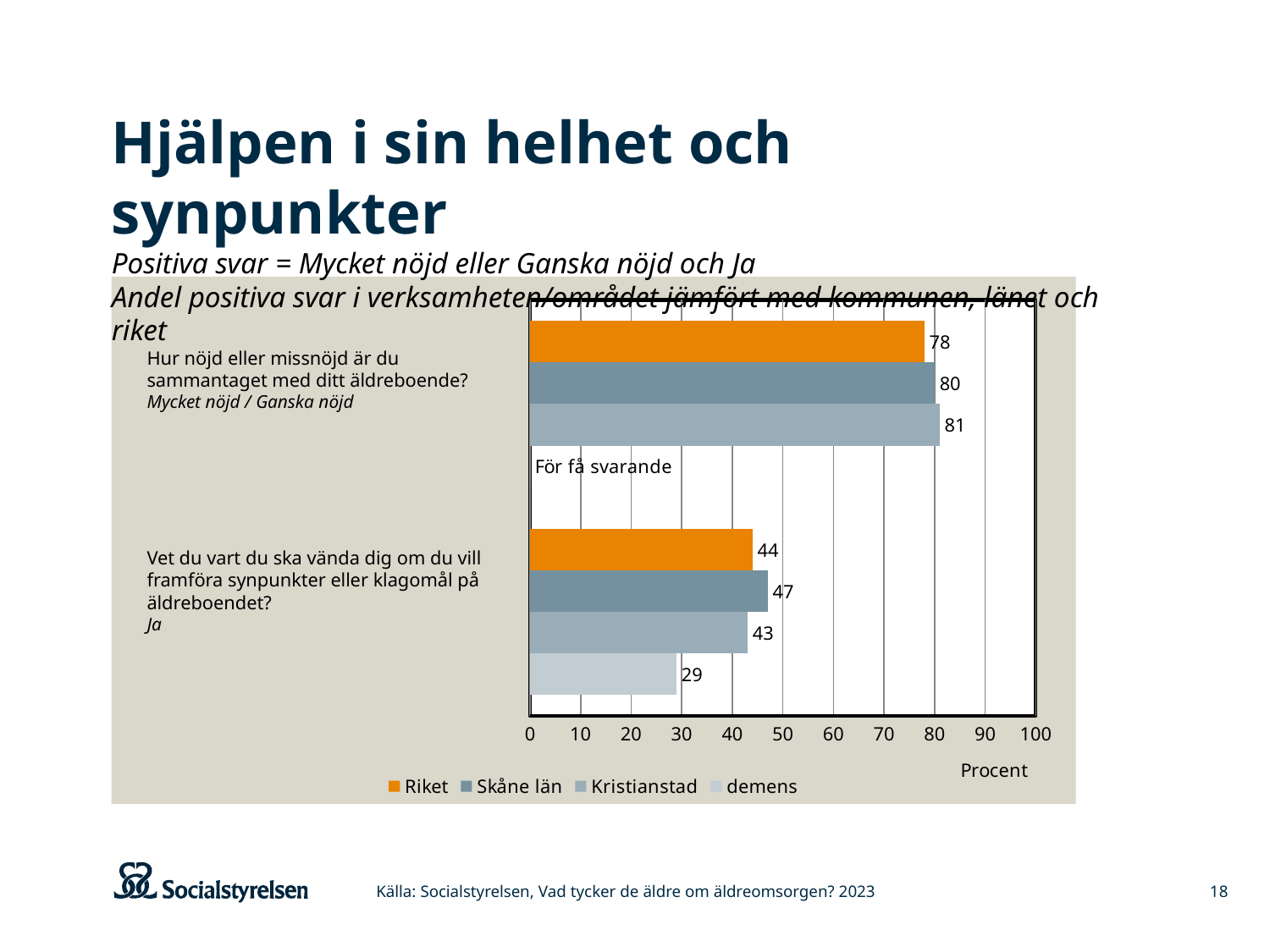
What is the label of the x axis? Procent Which is larger on the question "Vet du vart du ska vända dig om du vill framföra synpunkter eller klagomål på äldreboendet?": Riket or demens? Riket What is the value for Riket on the question "Hur nöjd eller missnöjd är du sammantaget med ditt äldreboende?"? 78 What is the value for Kristianstad on the question "Hur nöjd eller missnöjd är du sammantaget med ditt äldreboende?"? 81 How many series does the legend list? 4 What kind of chart is shown on the slide? bar chart What is the difference between the Skåne län and Riket values on the question "Hur nöjd eller missnöjd är du sammantaget med ditt äldreboende?"? 2 Which series has the lowest value on the question "Vet du vart du ska vända dig om du vill framföra synpunkter eller klagomål på äldreboendet?"? demens What is shown for demens on the question "Hur nöjd eller missnöjd är du sammantaget med ditt äldreboende?" instead of a bar? För få svarande What is the value for demens on the question "Vet du vart du ska vända dig om du vill framföra synpunkter eller klagomål på äldreboendet?"? 29 Which series has the highest value on the question "Vet du vart du ska vända dig om du vill framföra synpunkter eller klagomål på äldreboendet?"? Skåne län What is the value for Skåne län on the question "Vet du vart du ska vända dig om du vill framföra synpunkter eller klagomål på äldreboendet?"? 47